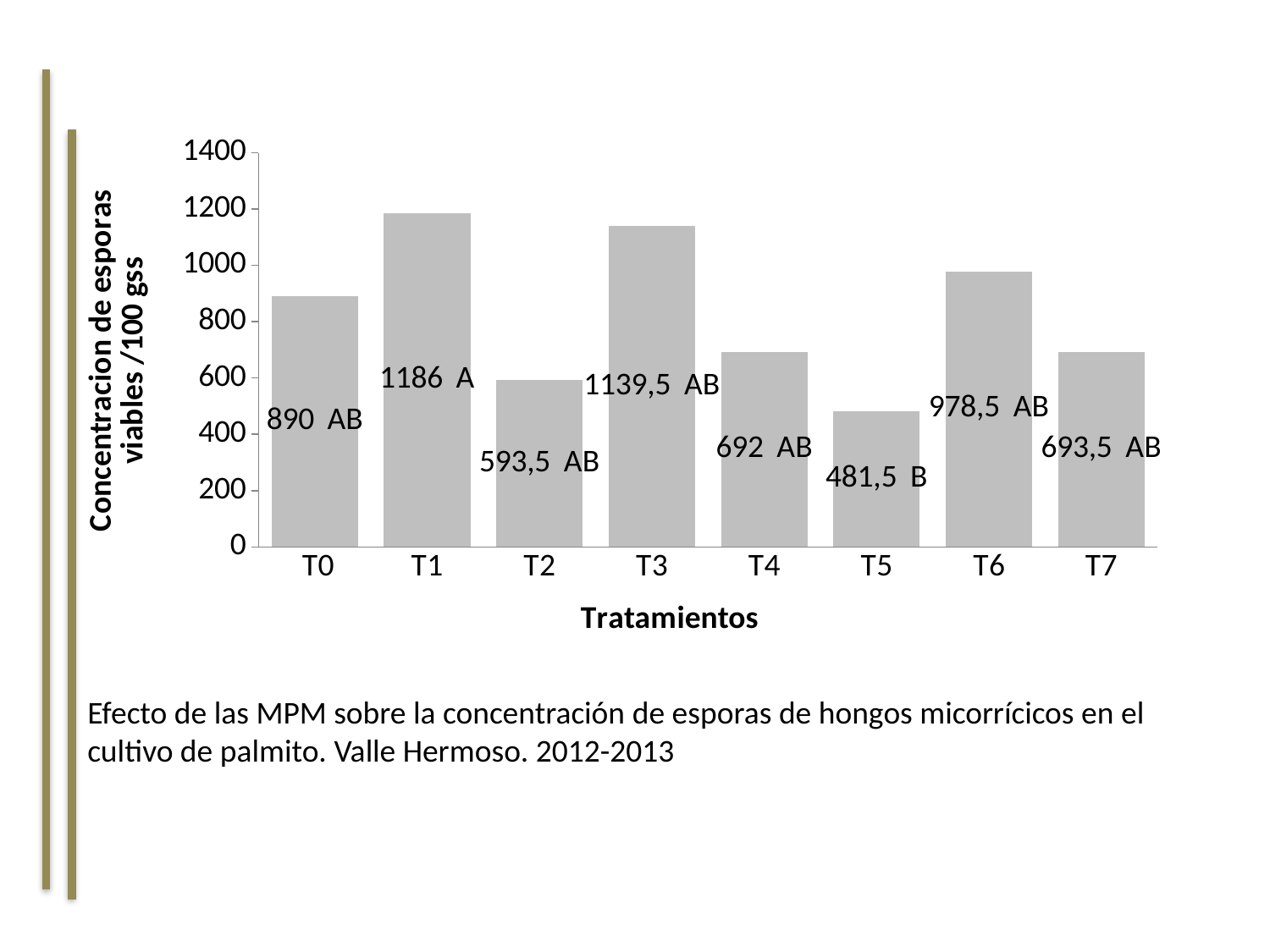
What is the value for T5? 481,5 What is the value for T3? 1139,5 What is the difference between the values for T0 and T4? 198 Which is larger, the value for T6 or the value for T2? T6 What kind of chart is shown on the slide? Bar chart What is the value for T1? 1186 What is the value for T6? 978,5 Which treatment has the lowest concentration of viable spores? T5 What is the label of the x axis? Tratamientos Which treatment has the highest concentration of viable spores? T1 How many treatments are shown on the x axis? 8 What is the difference between the values for T1 and T5? 704,5